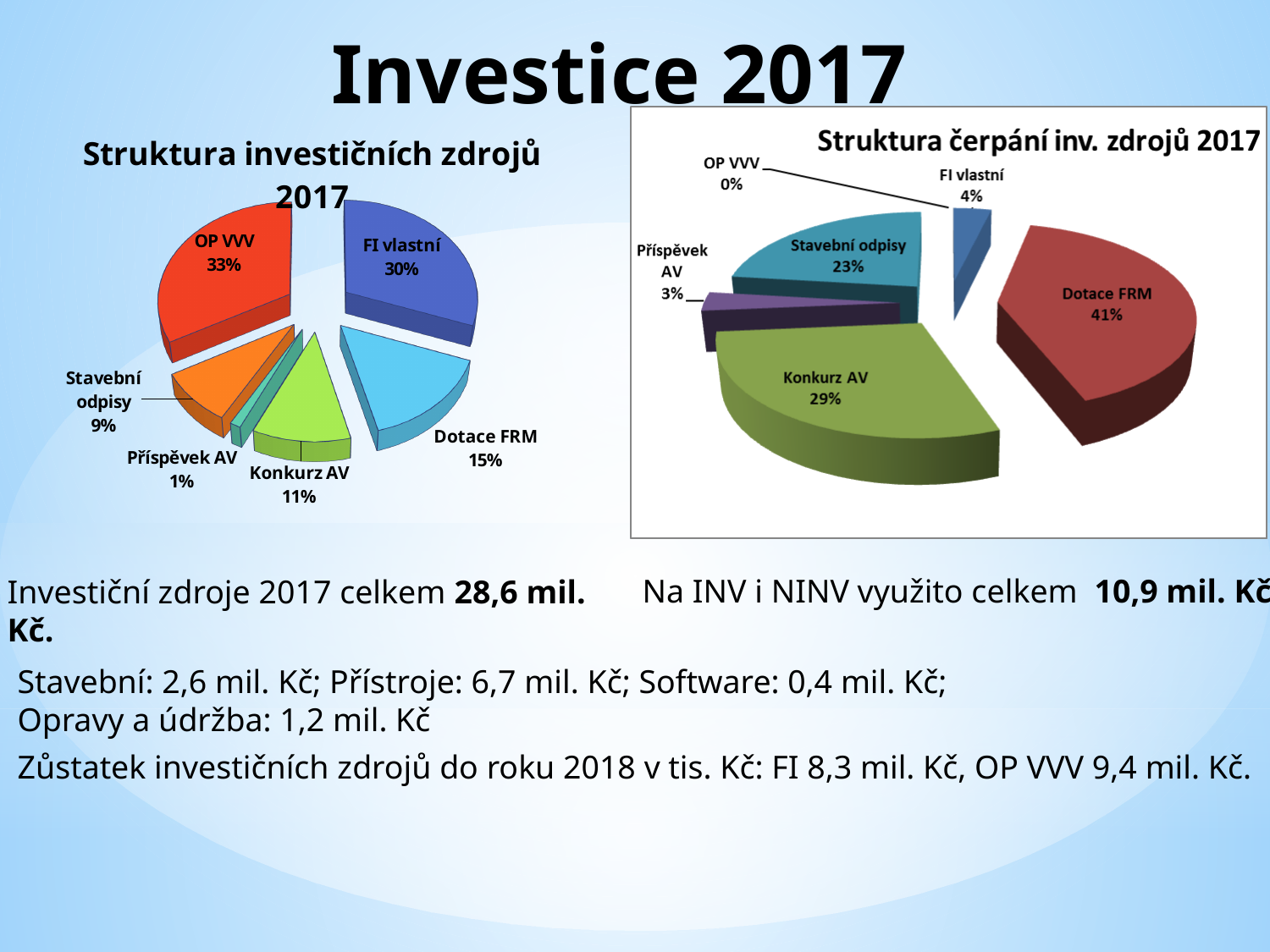
In the 'Struktura čerpání inv. zdrojů 2017' chart, what is the difference in percentage points between Dotace FRM and FI vlastní? 37 In the 'Struktura čerpání inv. zdrojů 2017' chart, which is larger, Konkurz AV or Stavební odpisy? Konkurz AV In the 'Struktura investičních zdrojů 2017' chart, what is the difference in percentage points between FI vlastní and Konkurz AV? 19 In the 'Struktura investičních zdrojů 2017' chart, what share does OP VVV have? 33% In the 'Struktura čerpání inv. zdrojů 2017' chart, which category has the smallest share? OP VVV In the 'Struktura investičních zdrojů 2017' chart, which category has the largest share? OP VVV How many slices does the 'Struktura investičních zdrojů 2017' chart have? 6 What kind of chart is 'Struktura čerpání inv. zdrojů 2017'? pie chart In the 'Struktura investičních zdrojů 2017' chart, what share does Dotace FRM have? 15% In the 'Struktura čerpání inv. zdrojů 2017' chart, what share does Dotace FRM have? 41% In the 'Struktura investičních zdrojů 2017' chart, which category has the smallest share? Příspěvek AV In the 'Struktura čerpání inv. zdrojů 2017' chart, what share does Stavební odpisy have? 23%